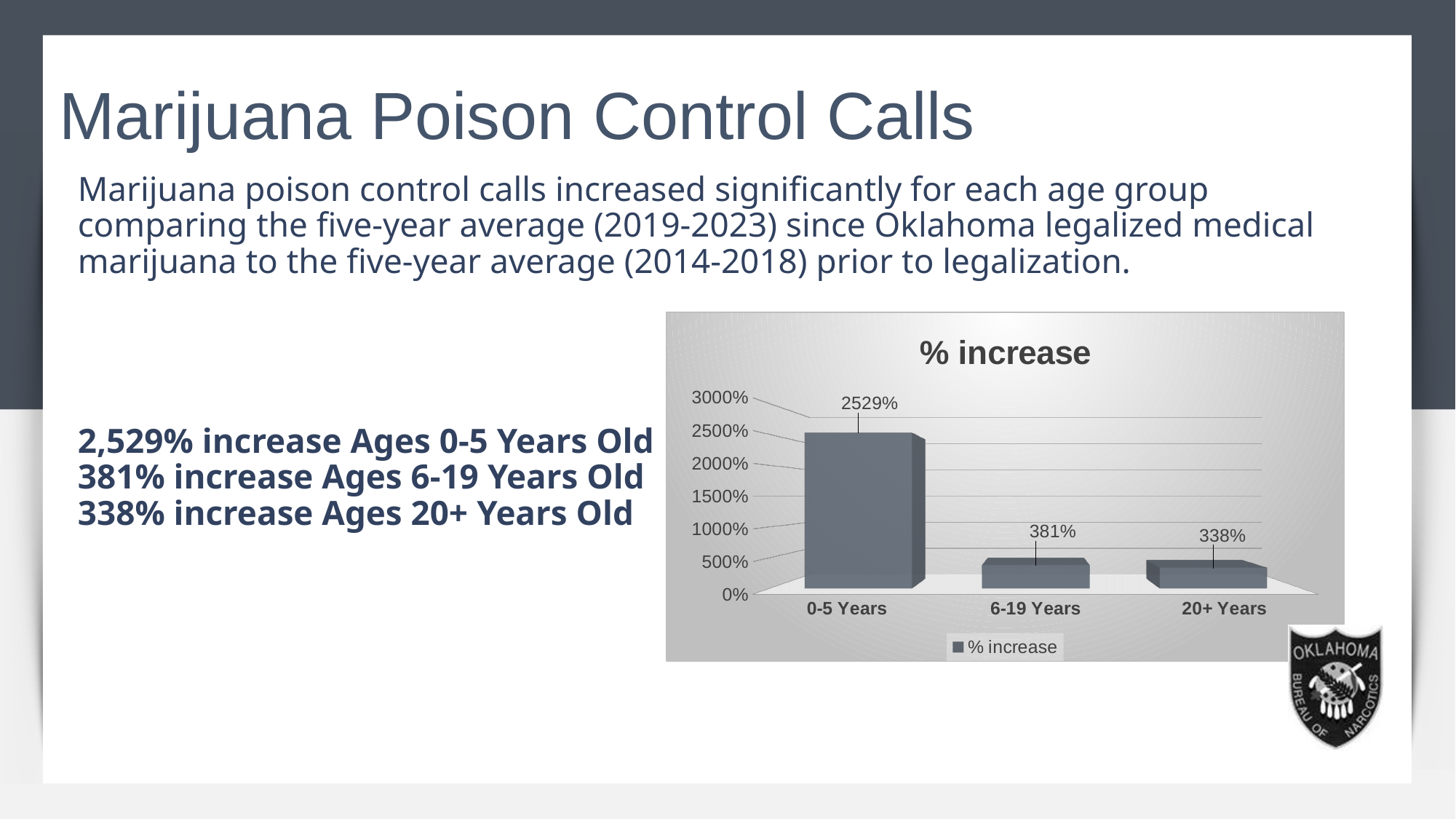
Is the value for 0-5 Years greater or less than 2000%? greater What kind of chart is shown on the slide? Bar chart How many age groups are shown in the chart? 3 What is the title of the chart? % increase What is the difference in % increase between the 0-5 Years and 6-19 Years groups? 2148% What is the % increase for the 0-5 Years age group? 2529% Which age group has the highest % increase? 0-5 Years Which has a larger % increase, 6-19 Years or 20+ Years? 6-19 Years What is the % increase for the 6-19 Years age group? 381% Which age group has the lowest % increase? 20+ Years What is the % increase for the 20+ Years age group? 338% What is the difference in % increase between the 6-19 Years and 20+ Years groups? 43%